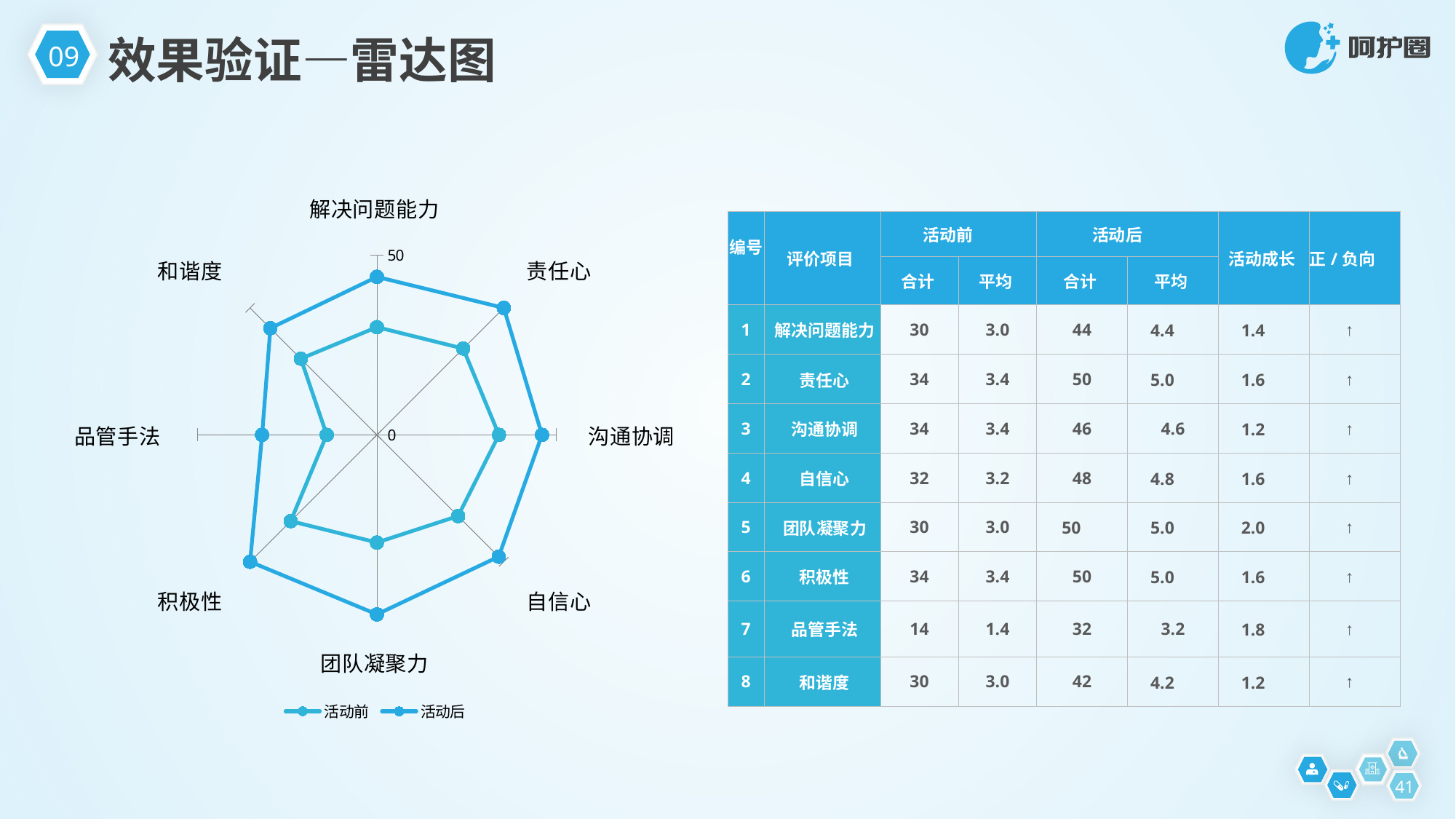
What is the maximum value shown on the radar chart's axis scale? 50 In the radar chart, which is larger for the 活动前 series: 责任心 or 品管手法? 责任心 In the radar chart, is the 活动后 value for 解决问题能力 greater or less than 50? less In the radar chart, which series has the larger value for 团队凝聚力, 活动前 or 活动后? 活动后 In the radar chart, which category has the lowest value for the 活动前 series? 品管手法 In the radar chart, which category has the lowest value for the 活动后 series? 品管手法 What are the two series named in the radar chart legend? 活动前 and 活动后 In the radar chart, which series has the larger value for 品管手法, 活动前 or 活动后? 活动后 How many categories (axes) does the radar chart have? 8 In the radar chart, is the 活动前 value for 品管手法 greater or less than 50? less What kind of chart is shown on the left of the slide? Radar chart How many series does the legend of the radar chart list? 2